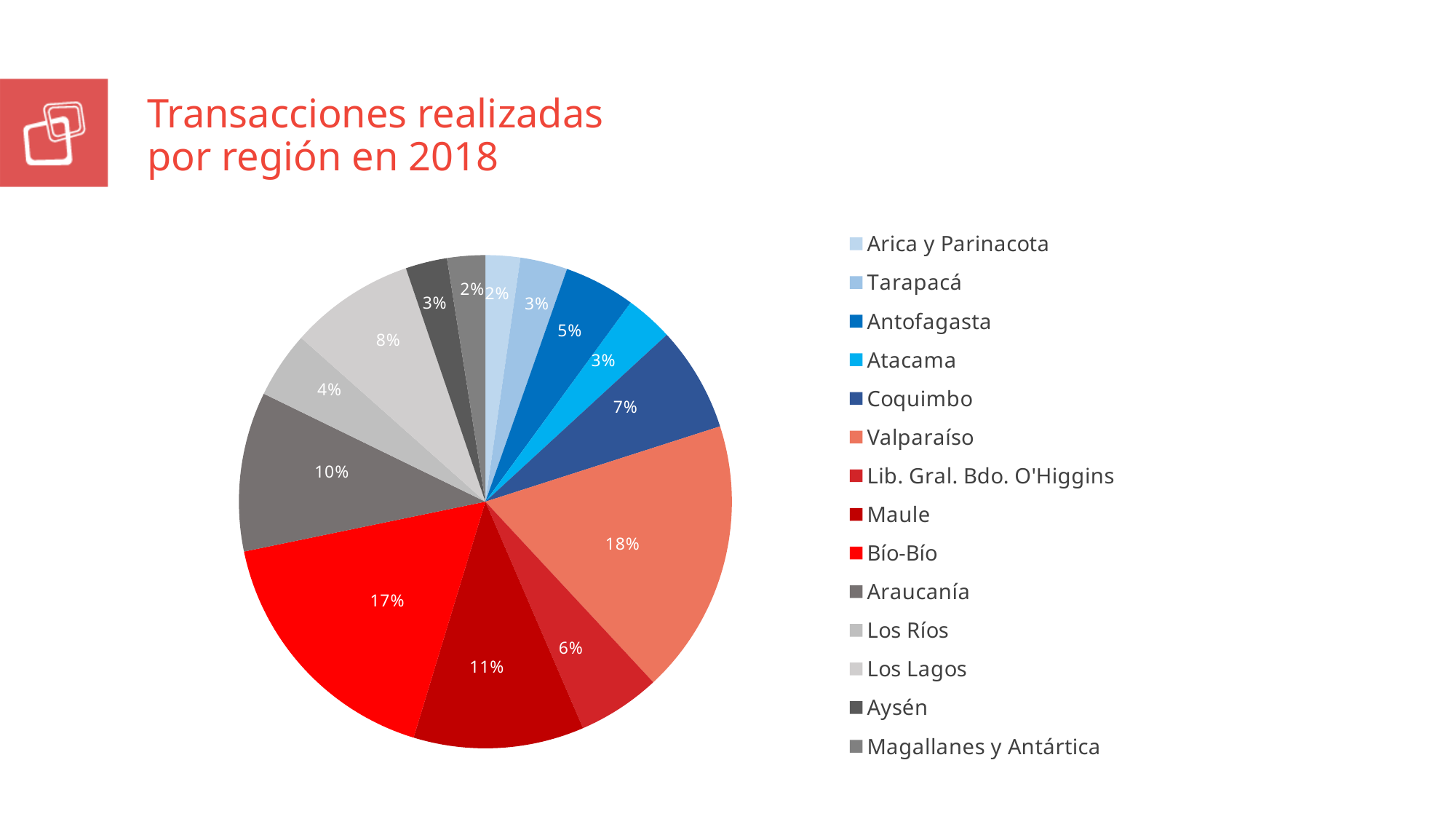
What type of chart is shown on the slide? pie chart What share of transactions does Bío-Bío account for? 17% What is the value shown for Maule? 11% What share of transactions does Valparaíso account for? 18% Which has a larger share, Antofagasta or Los Ríos? Antofagasta Which region has the largest share of transactions? Valparaíso What is the difference between the shares of Valparaíso and Maule? 7% What is the value shown for Coquimbo? 7% What is the title of the slide? Transacciones realizadas por región en 2018 How many regions are listed in the legend? 14 What is the value shown for Araucanía? 10% What is the value shown for Los Lagos? 8%